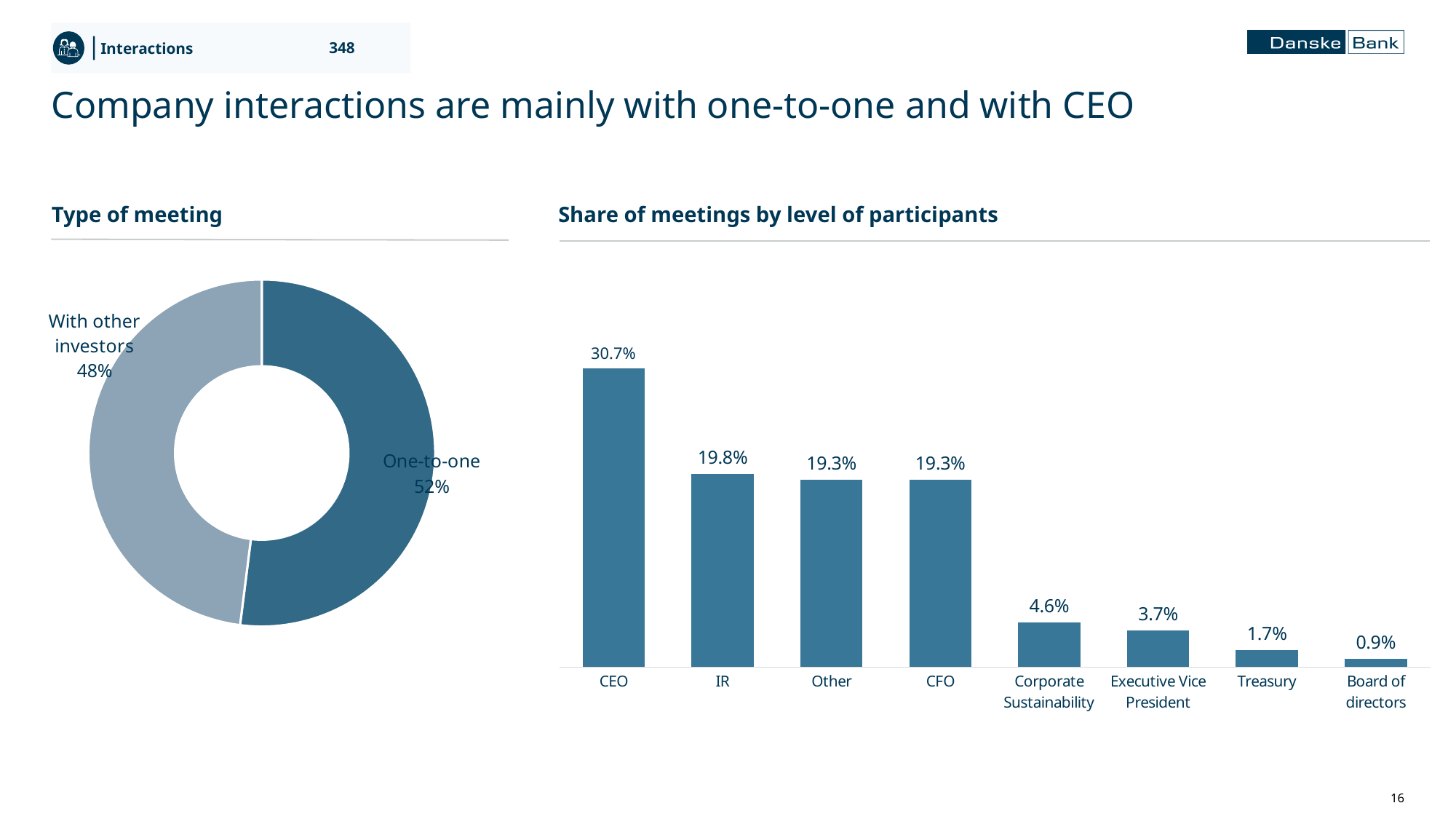
In the 'Share of meetings by level of participants' chart, what is the value for Corporate Sustainability? 4.6% In the 'Share of meetings by level of participants' chart, what is the difference between the CEO and IR values? 10.9% How many slices does the 'Type of meeting' chart have? 2 In the 'Type of meeting' chart, what share of meetings are one-to-one? 52% In the 'Share of meetings by level of participants' chart, which category has the lowest value? Board of directors In the 'Type of meeting' chart, what share of meetings are with other investors? 48% How many categories are shown in the 'Share of meetings by level of participants' chart? 8 In the 'Share of meetings by level of participants' chart, which is larger, the value for Treasury or the value for Executive Vice President? Executive Vice President In the 'Share of meetings by level of participants' chart, which category has the highest value? CEO What kind of chart is the 'Type of meeting' chart? Doughnut chart In the 'Share of meetings by level of participants' chart, what is the value for CEO? 30.7% What kind of chart is the 'Share of meetings by level of participants' chart? Bar chart